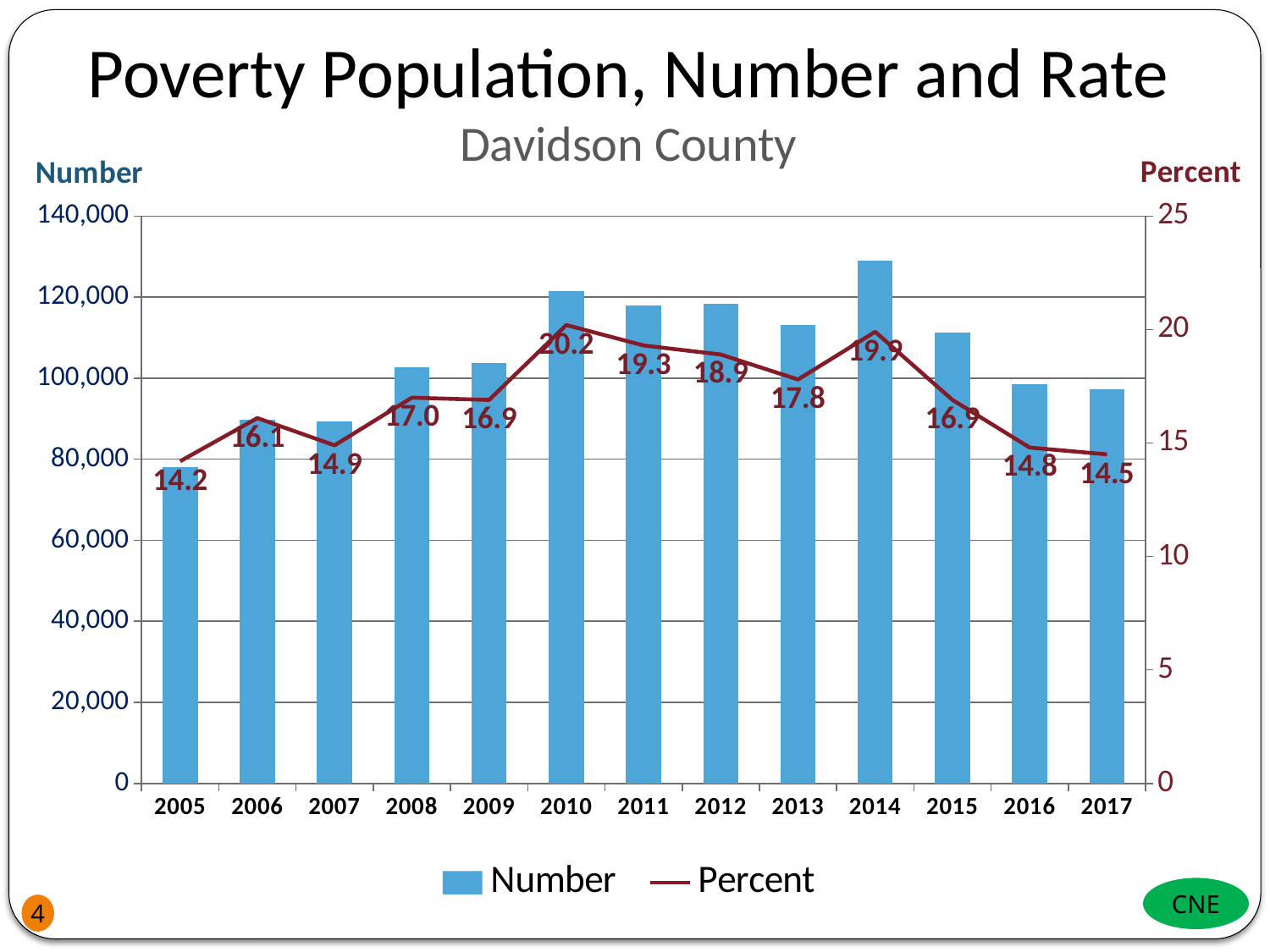
How many years are shown on the x axis? 13 Which year has the lowest Percent value? 2005 What is the difference between the Percent values for 2010 and 2005? 6.0 Is the Number value for 2014 greater or less than 120,000? greater What is the Percent value for 2010? 20.2 What is the Percent value for 2005? 14.2 Which year has the highest Percent value? 2010 Is the Number value for 2007 greater or less than 100,000? less Which is larger, the Percent value for 2011 or for 2012? 2011 How many series does the legend list? 2 What is the Percent value for 2014? 19.9 Which year has the tallest Number bar? 2014